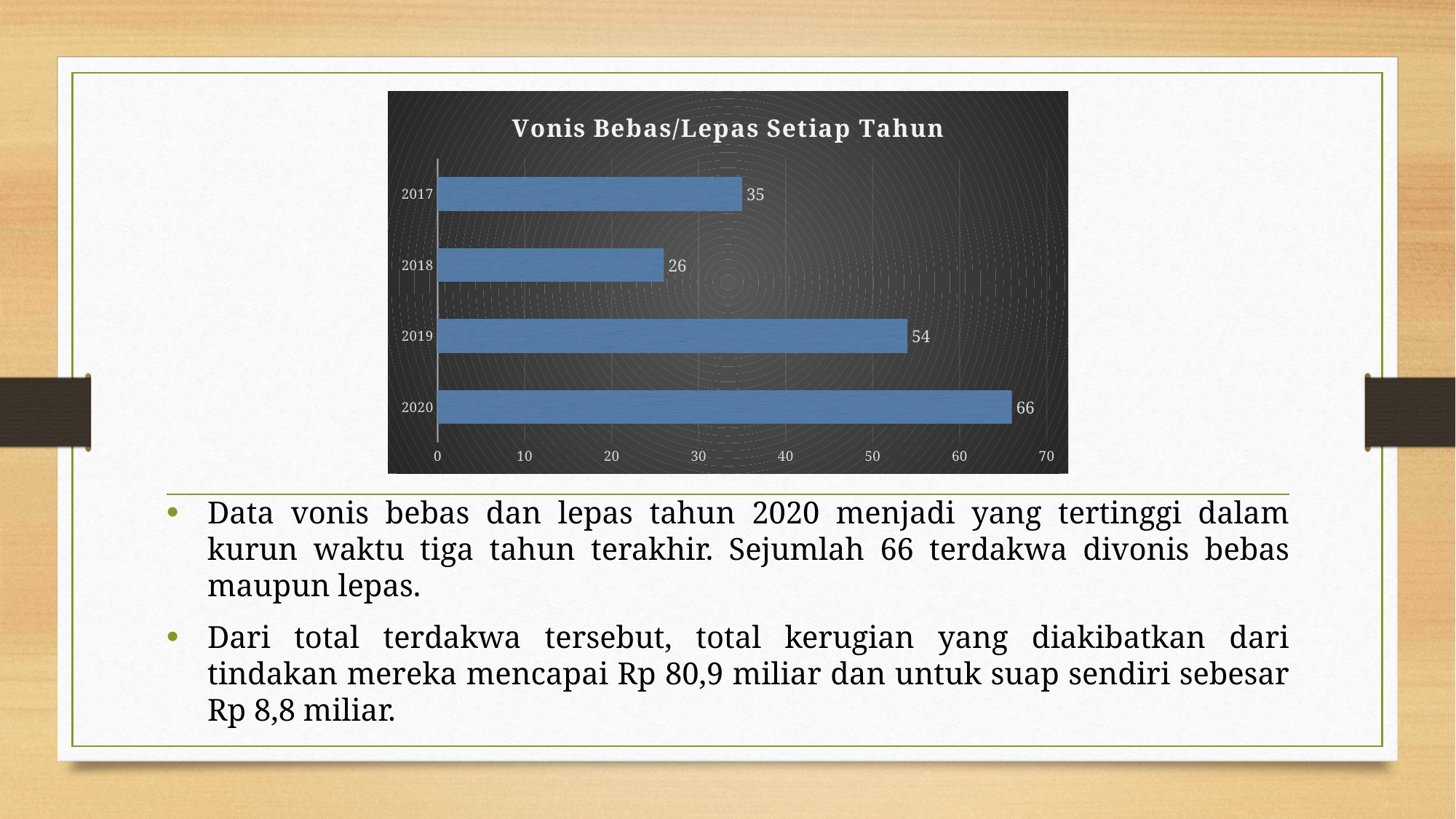
What is the value for 2020? 66 What is the difference between the values for 2020 and 2019? 12 Which year has the lowest value? 2018 Which year has the highest value? 2020 How many years are shown in the chart? 4 What is the value for 2019? 54 What kind of chart is shown on the slide? Bar chart What is the value for 2018? 26 What is the value for 2017? 35 What is the difference between the values for 2017 and 2018? 9 What is the title of the chart? Vonis Bebas/Lepas Setiap Tahun Which is larger, the value for 2017 or the value for 2019? 2019